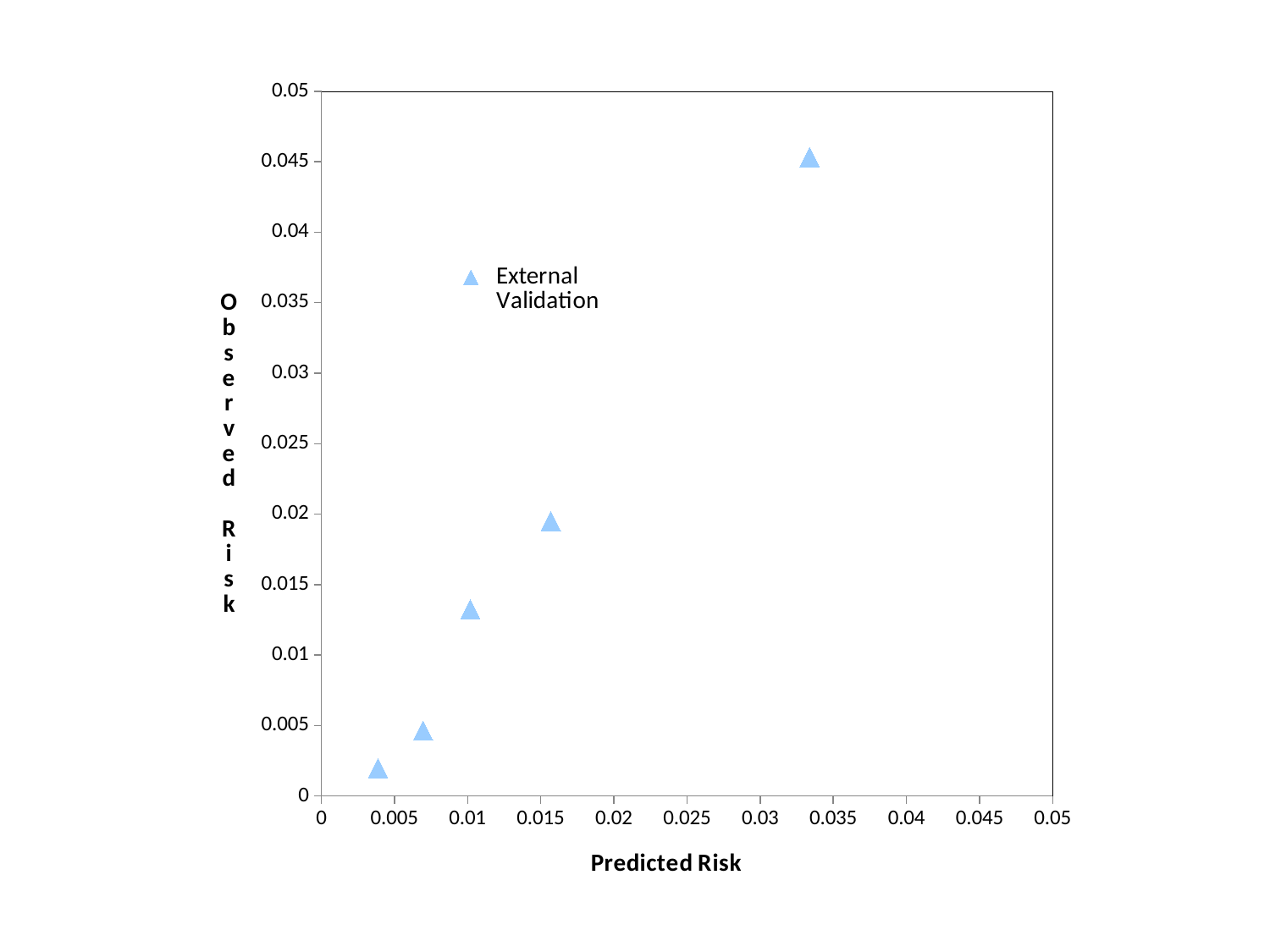
Is the predicted risk of the rightmost point greater or less than 0.03? greater What is the name of the series shown in the legend? External Validation Which is larger for the rightmost point: its predicted risk or its observed risk? Observed risk Is the predicted risk of the leftmost point greater or less than 0.005? less Is the observed risk of the point with the third-highest predicted risk greater or less than 0.01? greater What is the title of the x axis? Predicted Risk How many data points are plotted on the chart? 5 What kind of chart is shown on the slide? Scatter chart Do the observed risk values rise or fall as predicted risk increases along the x axis? Rise How many series does the legend list? 1